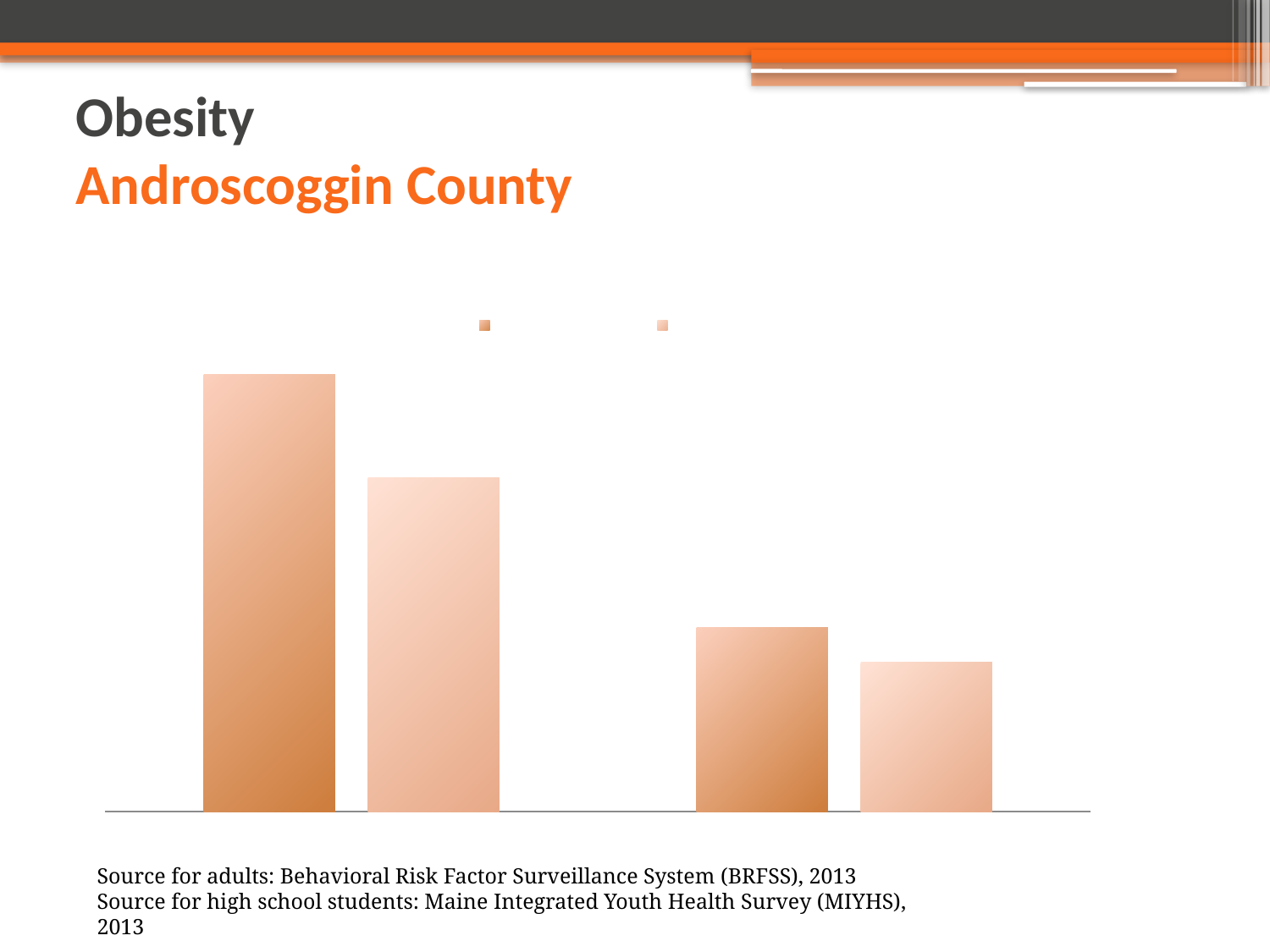
Is the leftmost bar taller or shorter than the second bar from the left? taller How many series does the chart's legend list? 2 How many bars are plotted in the chart? 4 Which bar is the tallest in the chart: the leftmost, second, third, or rightmost? the leftmost How many groups of bars are shown in the chart? 2 Is the third bar from the left taller or shorter than the rightmost bar? taller Do the bar heights rise or fall moving from left to right across the chart? fall What kind of chart is shown on the slide? bar chart Which county is named in the slide title above the chart? Androscoggin County What health topic does the slide title say the chart is about? Obesity Which bar is the shortest in the chart: the leftmost, second, third, or rightmost? the rightmost